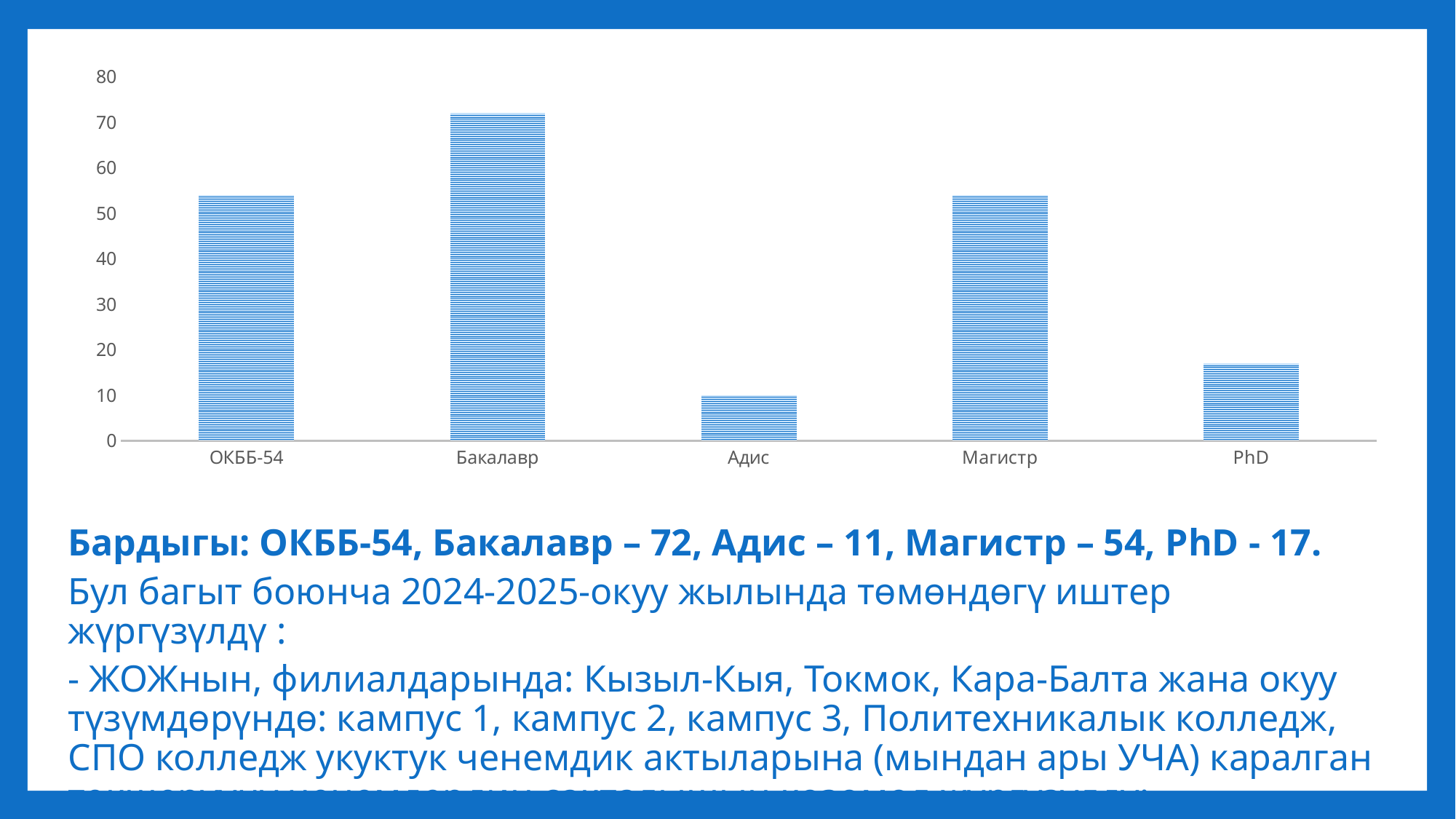
Which is larger, the value for PhD or the value for Адис? PhD Is the value for ОКББ-54 greater or less than 50? greater What is the value for Бакалавр? 72 Which category has the lowest bar in the chart? Адис Which category has the highest bar in the chart? Бакалавр What kind of chart is shown on the slide? bar chart How many categories are shown on the x axis of the chart? 5 Is the value for PhD greater or less than 20? less What is the value for PhD? 17 What is the value for Магистр? 54